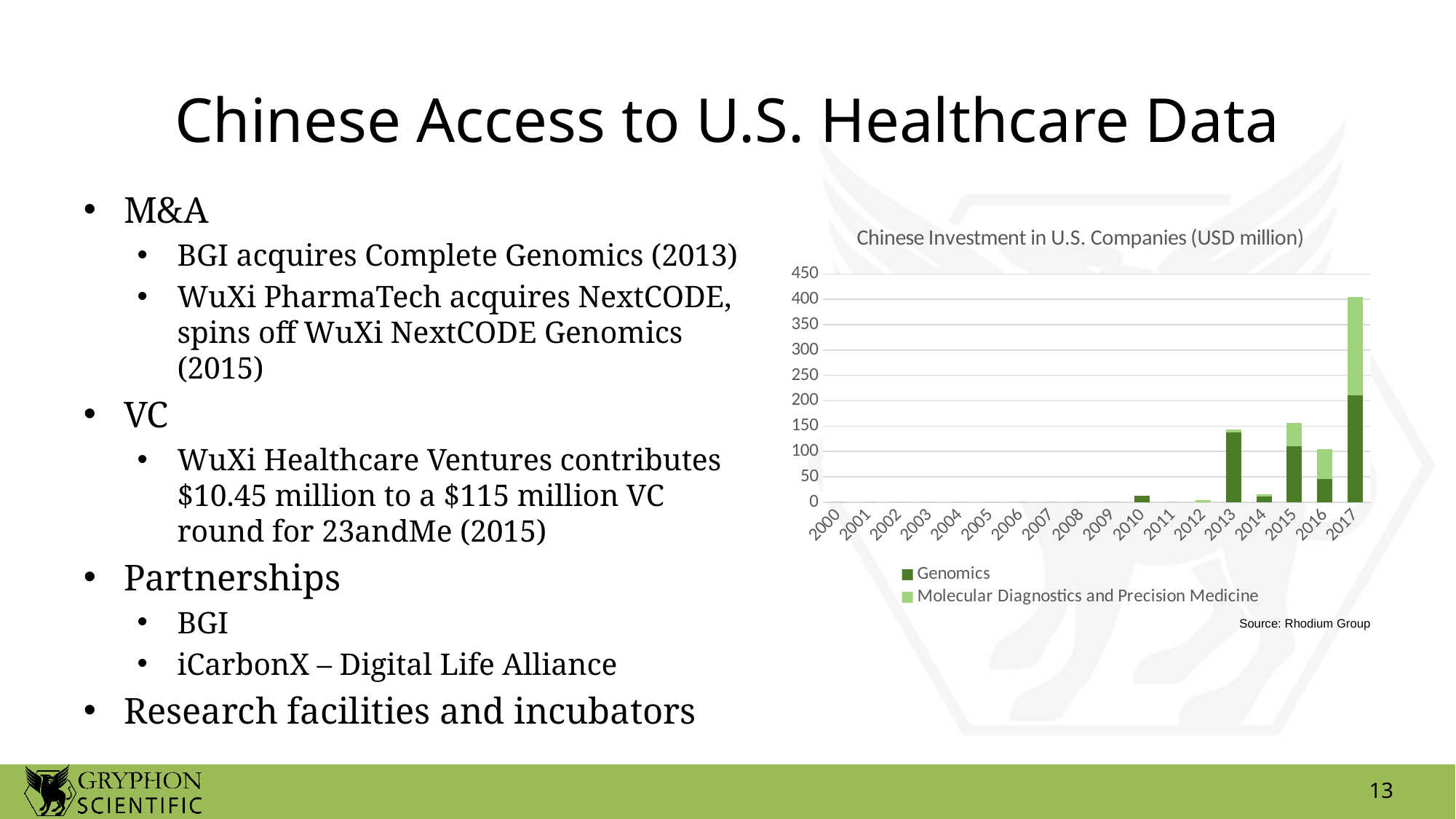
Which two series are listed in the chart's legend? Genomics; Molecular Diagnostics and Precision Medicine Is the total value for 2016 greater or less than 150? less Is the total value for 2017 greater or less than 350? greater What kind of chart is shown on the slide? Stacked bar chart Which year has the highest total Chinese investment in the chart? 2017 Which year has the larger total investment, 2015 or 2016? 2015 Is the total value for 2013 greater or less than 100? greater How many series does the chart's legend list? 2 What is the title of the chart? Chinese Investment in U.S. Companies (USD million) How many years are shown along the x axis of the chart? 18 Which year has the larger total investment, 2013 or 2014? 2013